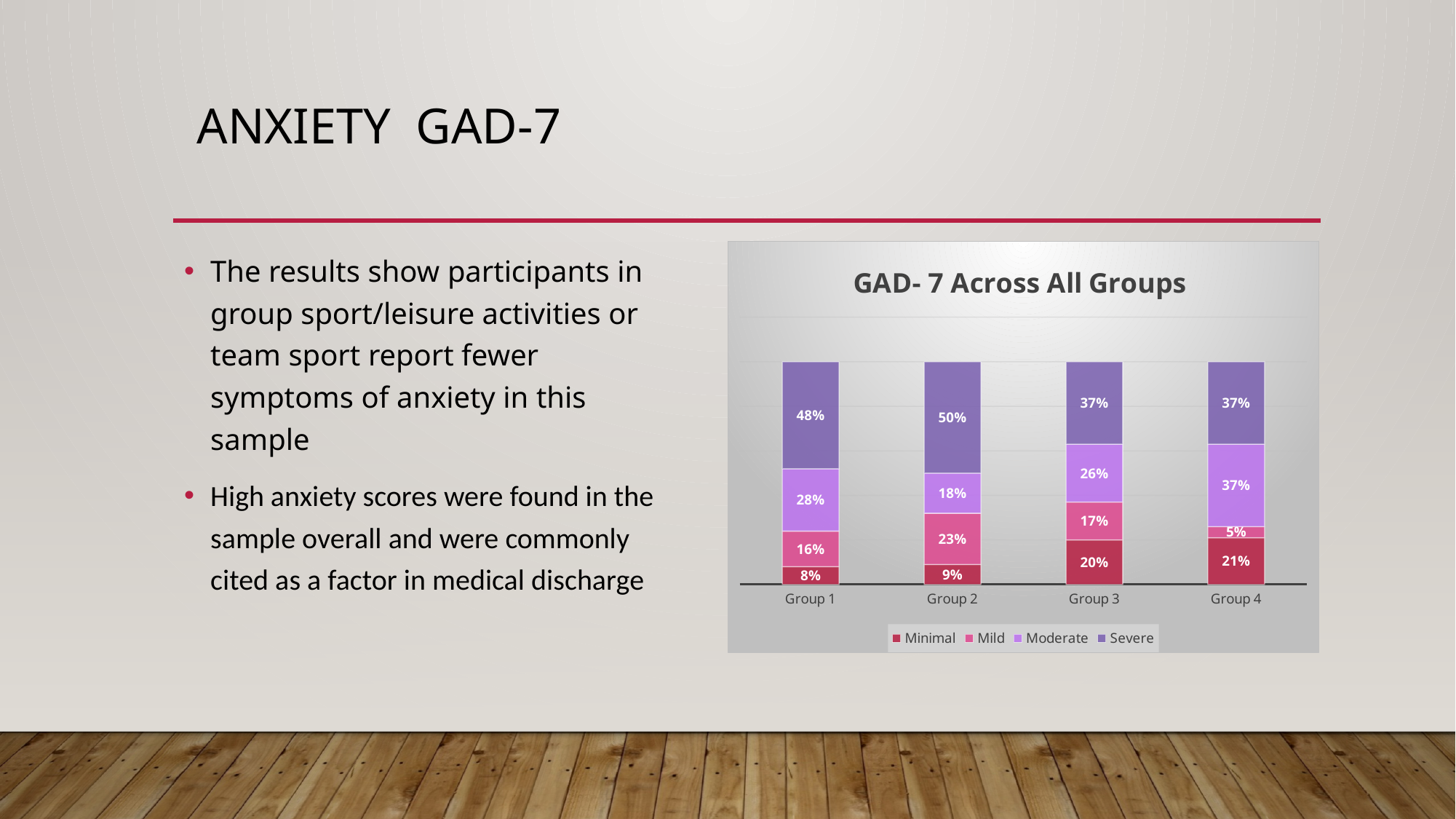
Which is larger: the Mild value for Group 2 or the Mild value for Group 3? Group 2 What is the total of the stacked bar for Group 1? 100% How many series does the chart legend list? 4 Which group has the lowest Minimal value? Group 1 How many groups are shown on the x axis of the chart? 4 Which group has the highest Severe value? Group 2 What is the title of the chart? GAD- 7 Across All Groups What is the Moderate value for Group 3? 26% What type of chart is shown on the slide? Stacked bar chart What is the Mild value for Group 4? 5% What is the difference between the Moderate values for Group 4 and Group 2? 19% What is the Severe value for Group 2? 50%